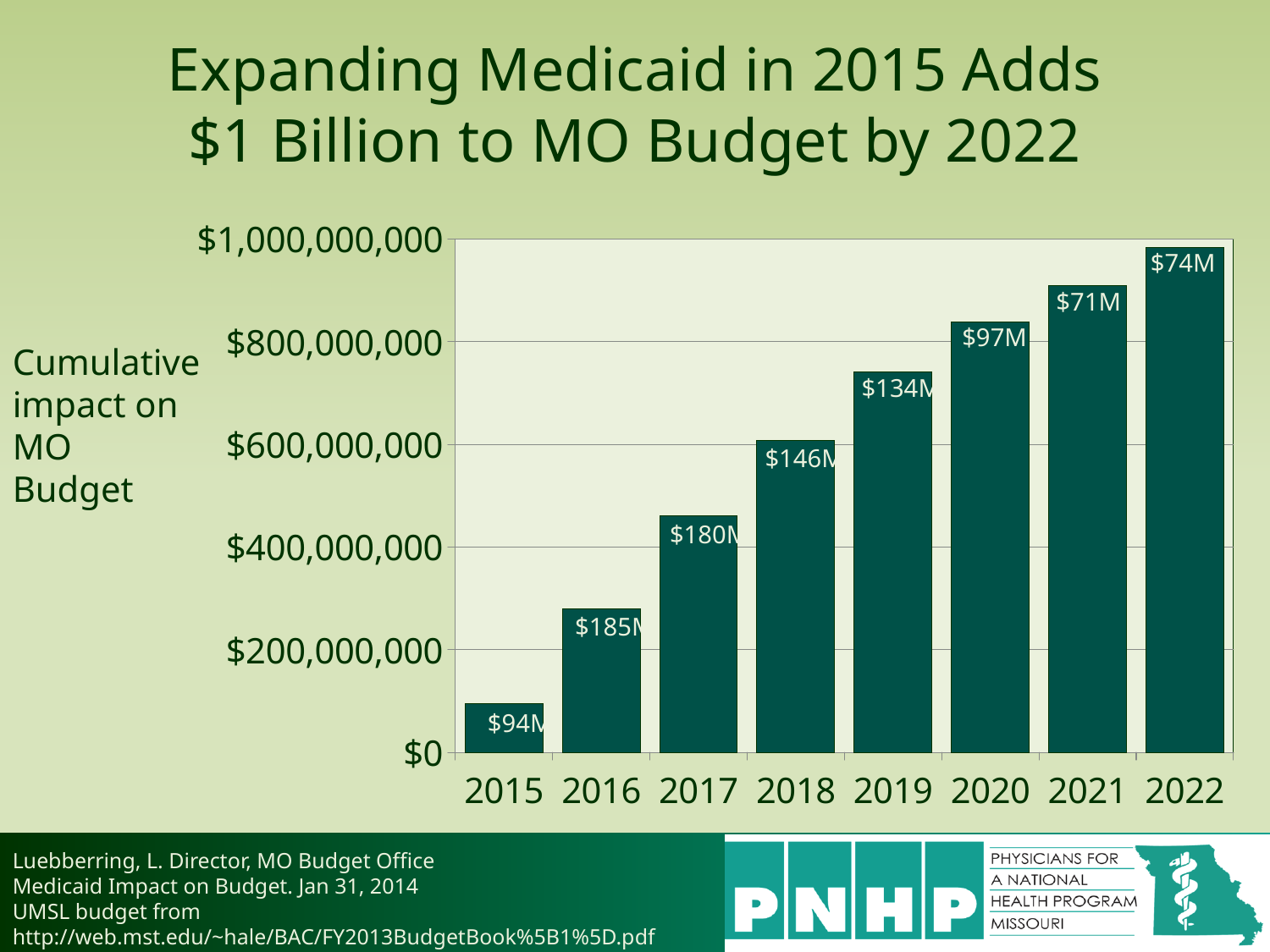
What is the data label shown on the 2021 bar? $71M What is the data label shown on the 2022 bar? $74M What kind of chart is shown on the slide? bar chart Which year has the tallest bar in the chart? 2022 Is the cumulative value for 2020 greater or less than $800,000,000? greater Which data label is larger, the one on the 2020 bar or the one on the 2021 bar? 2020 What label appears to the left of the chart describing the y axis? Cumulative impact on MO Budget What is the data label shown on the 2020 bar? $97M How many years are shown on the x axis of the chart? 8 Is the cumulative value for 2015 greater or less than $200,000,000? less Which year has the shortest bar in the chart? 2015 Do the bar heights rise or fall from 2015 to 2022? rise